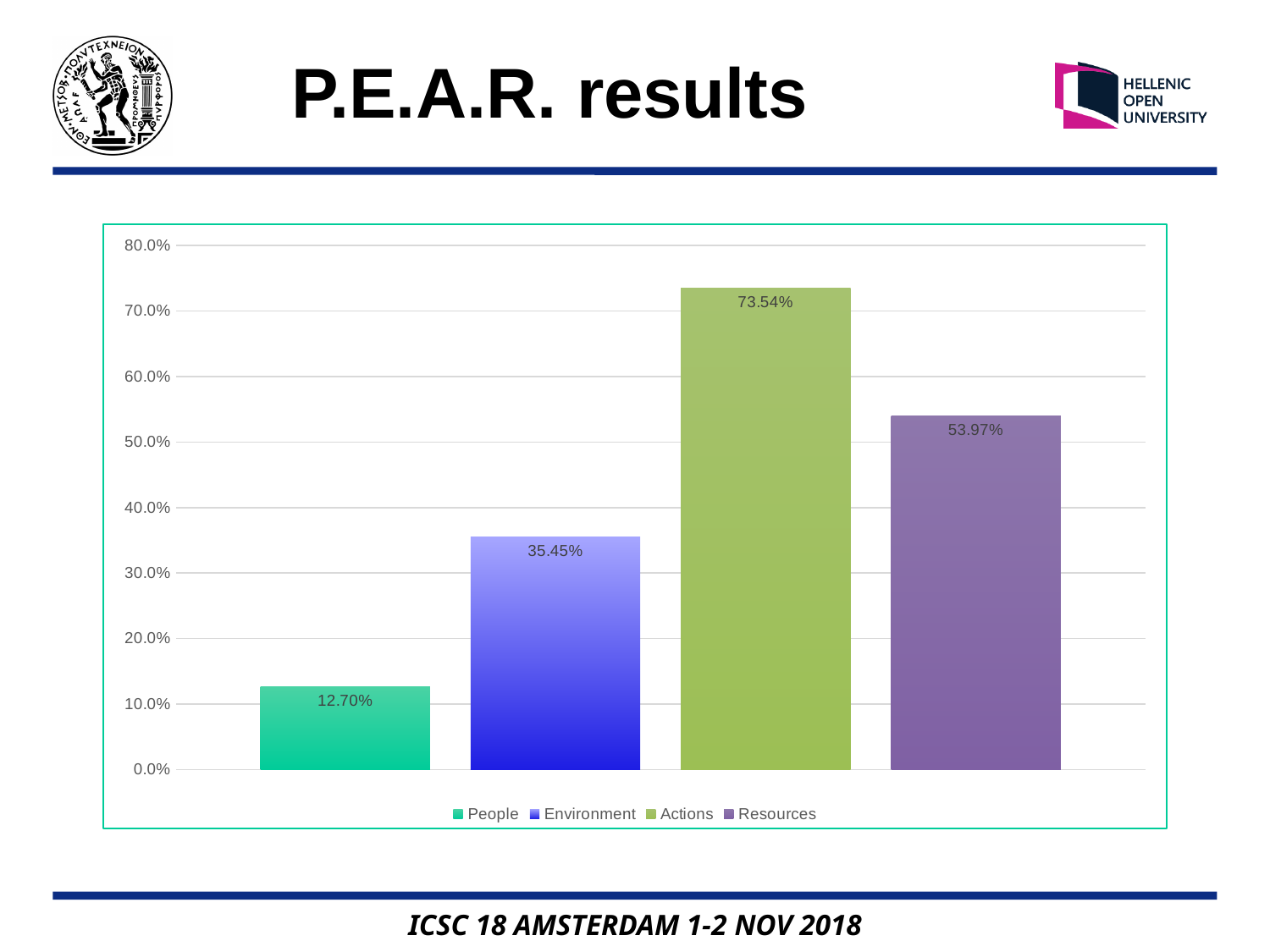
What is the value for Actions? 73.54% How many categories are shown in the chart? 4 What is the value for Resources? 53.97% Which category has the lowest value? People How many entries does the legend list? 4 What is the difference between the values for Actions and Resources? 19.57% What kind of chart is shown on the slide? Bar chart What is the value for Environment? 35.45% Which is larger, the value for Environment or the value for Resources? Resources What is the value for People? 12.70% Which category has the highest value? Actions What is the difference between the values for Environment and People? 22.75%